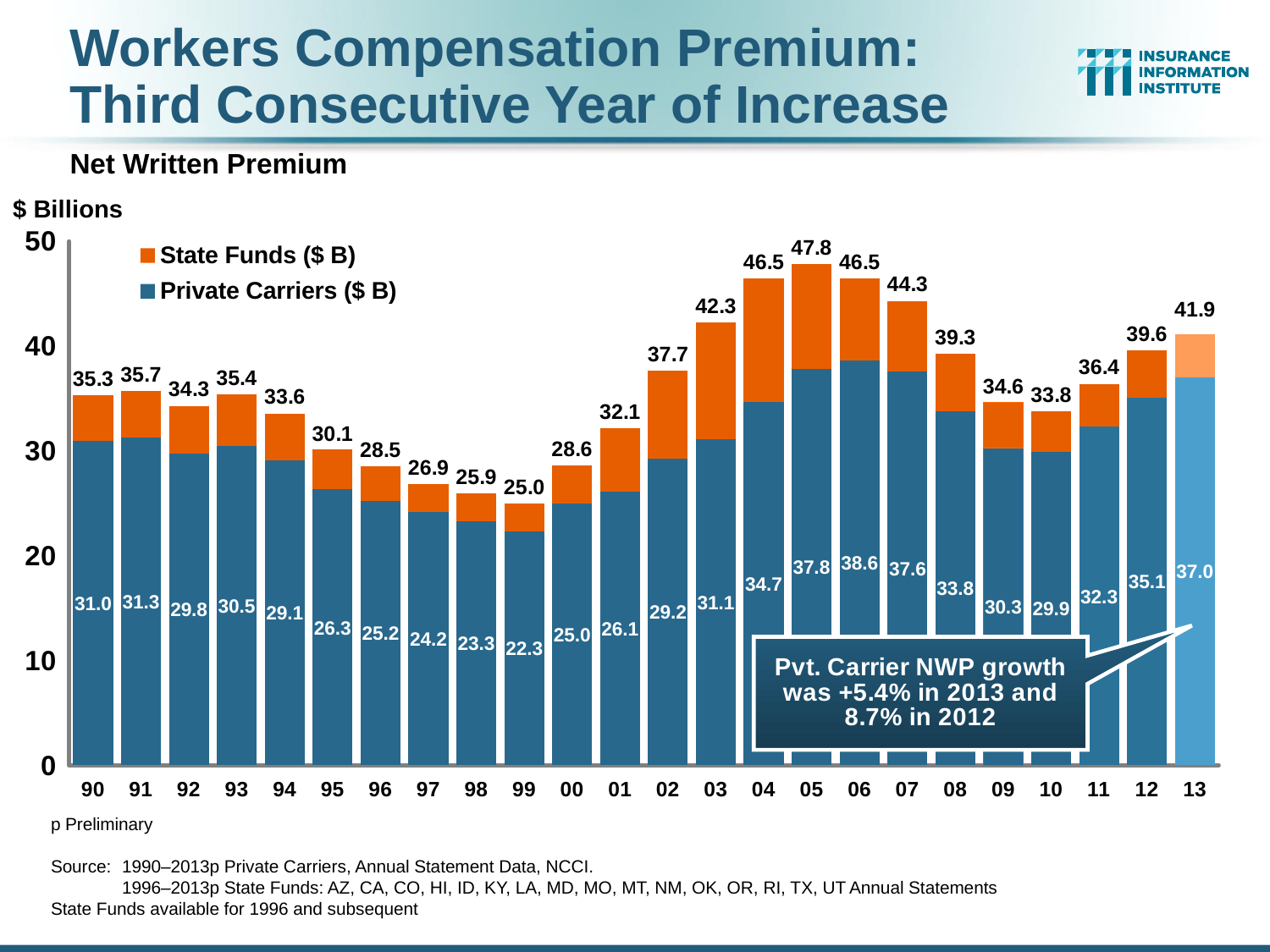
What kind of chart is shown on the slide? Stacked bar chart What is the Private Carriers value for 2013? 37.0 What is the difference between the total for 2013 (41.9) and the Private Carriers value for 2013 (37.0)? 4.9 How many years are shown on the x axis? 24 Which year has the highest total net written premium? 05 What is the total net written premium shown above the bar for 2005? 47.8 Which year has the larger total net written premium, 2012 or 2013? 13 How many series does the legend list? 2 Is the Private Carriers value for 2005 greater or less than 30? greater Which year has the lowest total net written premium? 99 Which year has the lowest Private Carriers value? 99 What is the Private Carriers value for 1999? 22.3